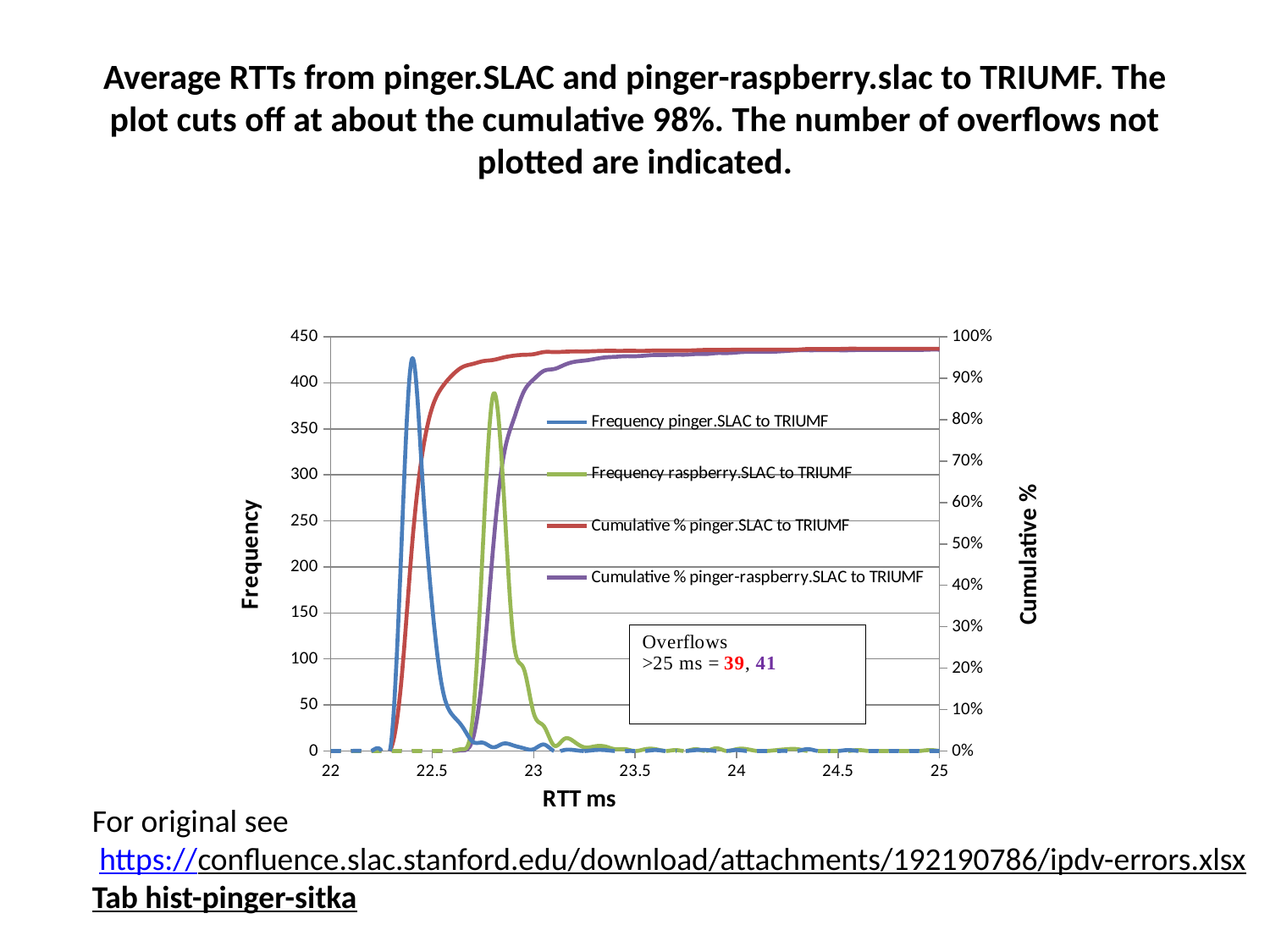
How many series does the legend list? 4 Is the peak value of the Frequency raspberry.SLAC to TRIUMF series greater or less than 400? less Is the peak value of the Frequency pinger.SLAC to TRIUMF series greater or less than 400? greater According to the annotation box, how many overflows above 25 ms are there for pinger.SLAC to TRIUMF (shown in red)? 39 Is the peak value of the Frequency raspberry.SLAC to TRIUMF series greater or less than 350? greater Which frequency series reaches the higher peak, pinger.SLAC to TRIUMF or raspberry.SLAC to TRIUMF? Frequency pinger.SLAC to TRIUMF According to the annotation box, how many overflows above 25 ms are there for pinger-raspberry.SLAC to TRIUMF (shown in purple)? 41 What kind of chart is shown on the slide? line chart What is the title of the right-hand vertical axis? Cumulative % Which frequency series peaks at a lower RTT, pinger.SLAC to TRIUMF or raspberry.SLAC to TRIUMF? Frequency pinger.SLAC to TRIUMF What is the title of the x axis? RTT ms Do the cumulative % series rise or fall as RTT increases along the x axis? rise